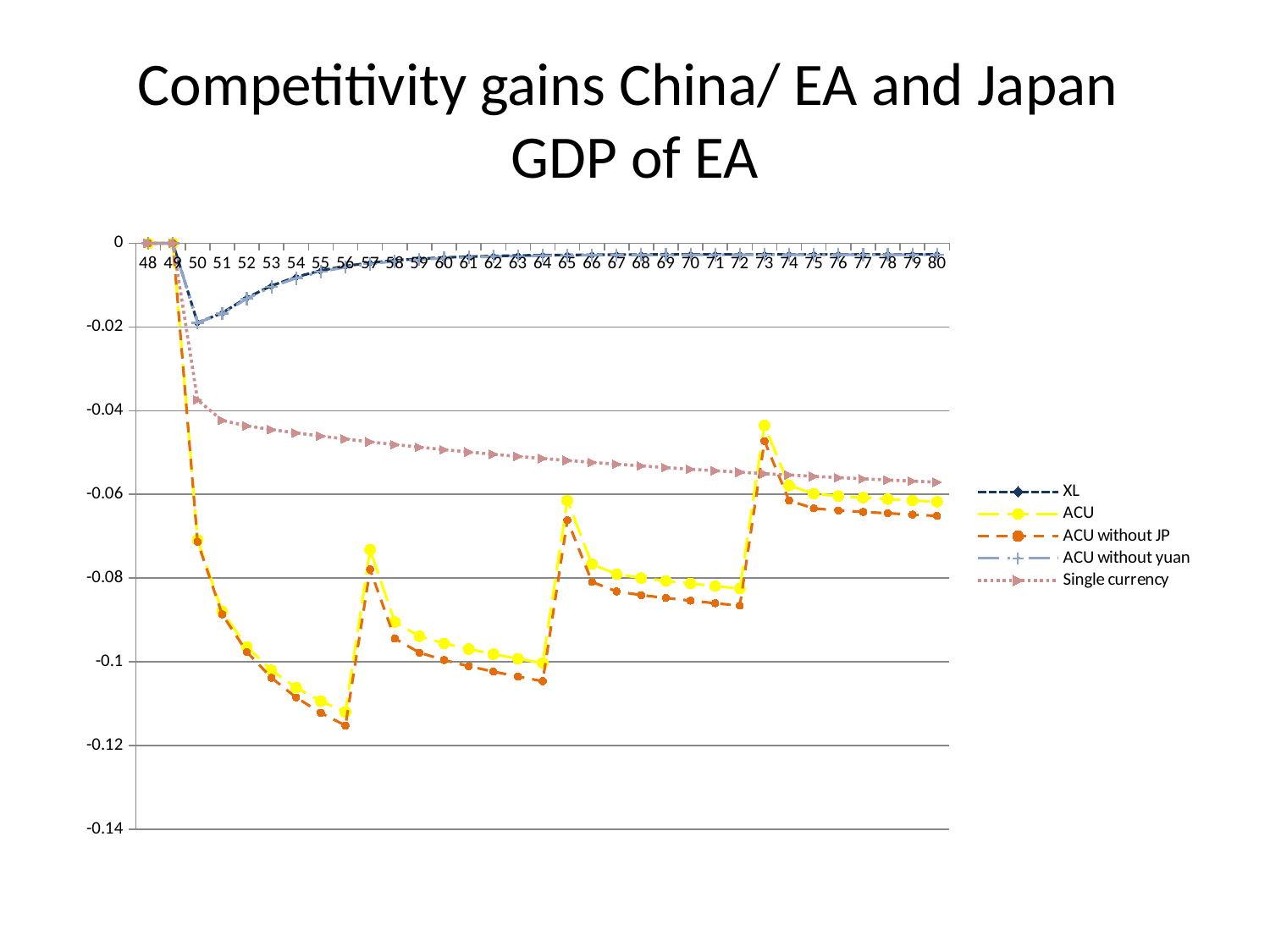
Is the value for ACU without JP at 56 greater or less than -0.1? less What is the value of the Single currency series at 49? 0 Is the value for Single currency at 80 greater or less than -0.06? greater Does the Single currency series rise or fall from 50 to 80? fall Is the value for ACU at 73 greater or less than -0.06? greater What kind of chart is shown on the slide? line chart How many series does the legend list? 5 At 56, which is larger: the value for Single currency or the value for ACU without JP? Single currency What is the value of the ACU series at 48? 0 How many points are on the x axis (from 48 to 80)? 33 Which series has the lowest value at 56? ACU without JP